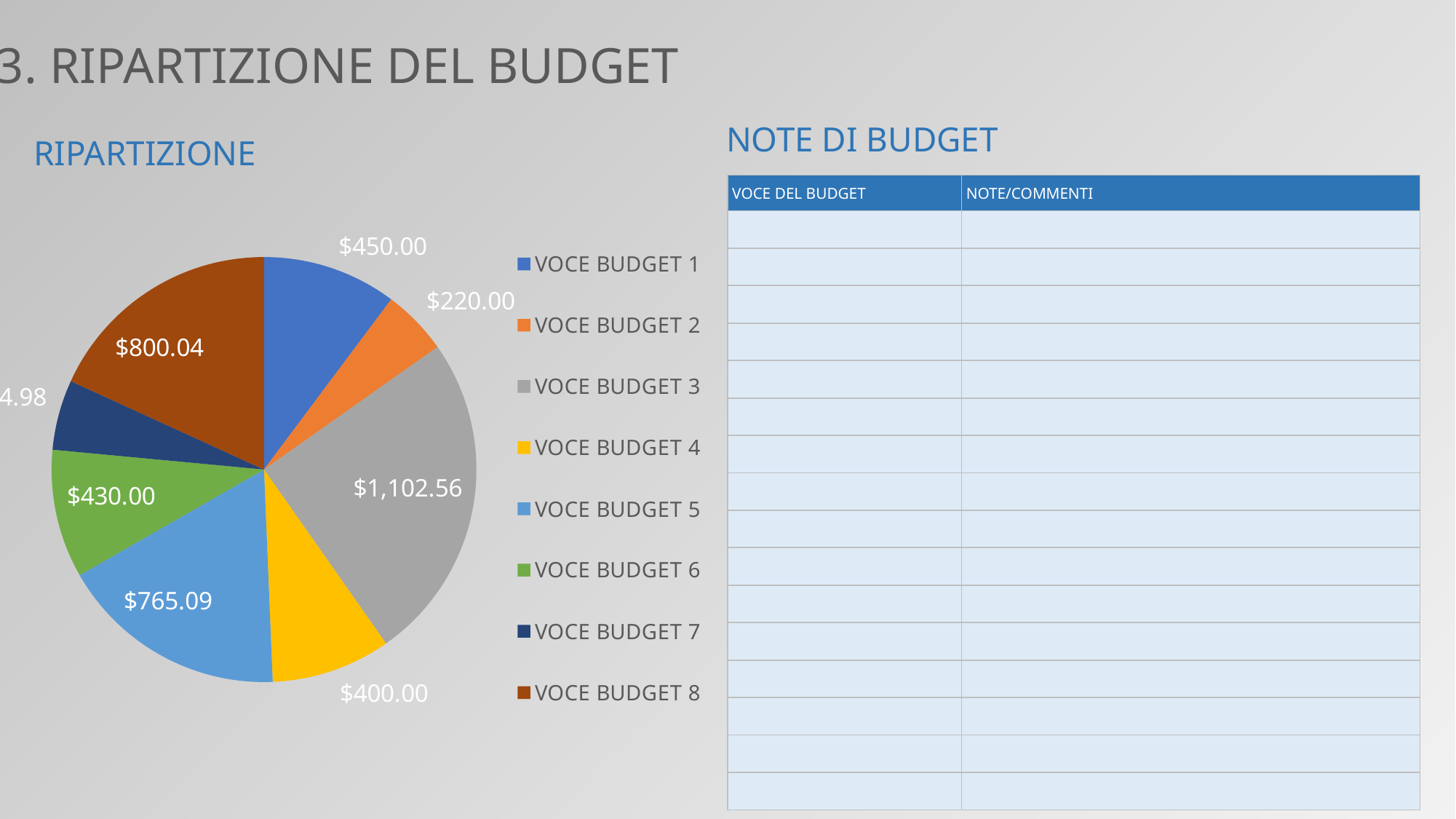
What is the difference between the values for VOCE BUDGET 3 and VOCE BUDGET 1 in the RIPARTIZIONE pie chart? $652.56 What is the value for VOCE BUDGET 3 in the RIPARTIZIONE pie chart? $1,102.56 What is the value for VOCE BUDGET 5 in the RIPARTIZIONE pie chart? $765.09 What kind of chart is the RIPARTIZIONE chart? Pie chart In the RIPARTIZIONE pie chart, which is larger: VOCE BUDGET 6 or VOCE BUDGET 2? VOCE BUDGET 6 In the RIPARTIZIONE pie chart, which is larger: VOCE BUDGET 8 or VOCE BUDGET 5? VOCE BUDGET 8 What is the difference between the values for VOCE BUDGET 1 and VOCE BUDGET 4 in the RIPARTIZIONE pie chart? $50.00 What colour is the VOCE BUDGET 4 slice in the RIPARTIZIONE pie chart? Yellow Which budget item has the largest slice in the RIPARTIZIONE pie chart? VOCE BUDGET 3 What is the value for VOCE BUDGET 8 in the RIPARTIZIONE pie chart? $800.04 How many budget items are shown in the RIPARTIZIONE pie chart? 8 What is the value for VOCE BUDGET 2 in the RIPARTIZIONE pie chart? $220.00